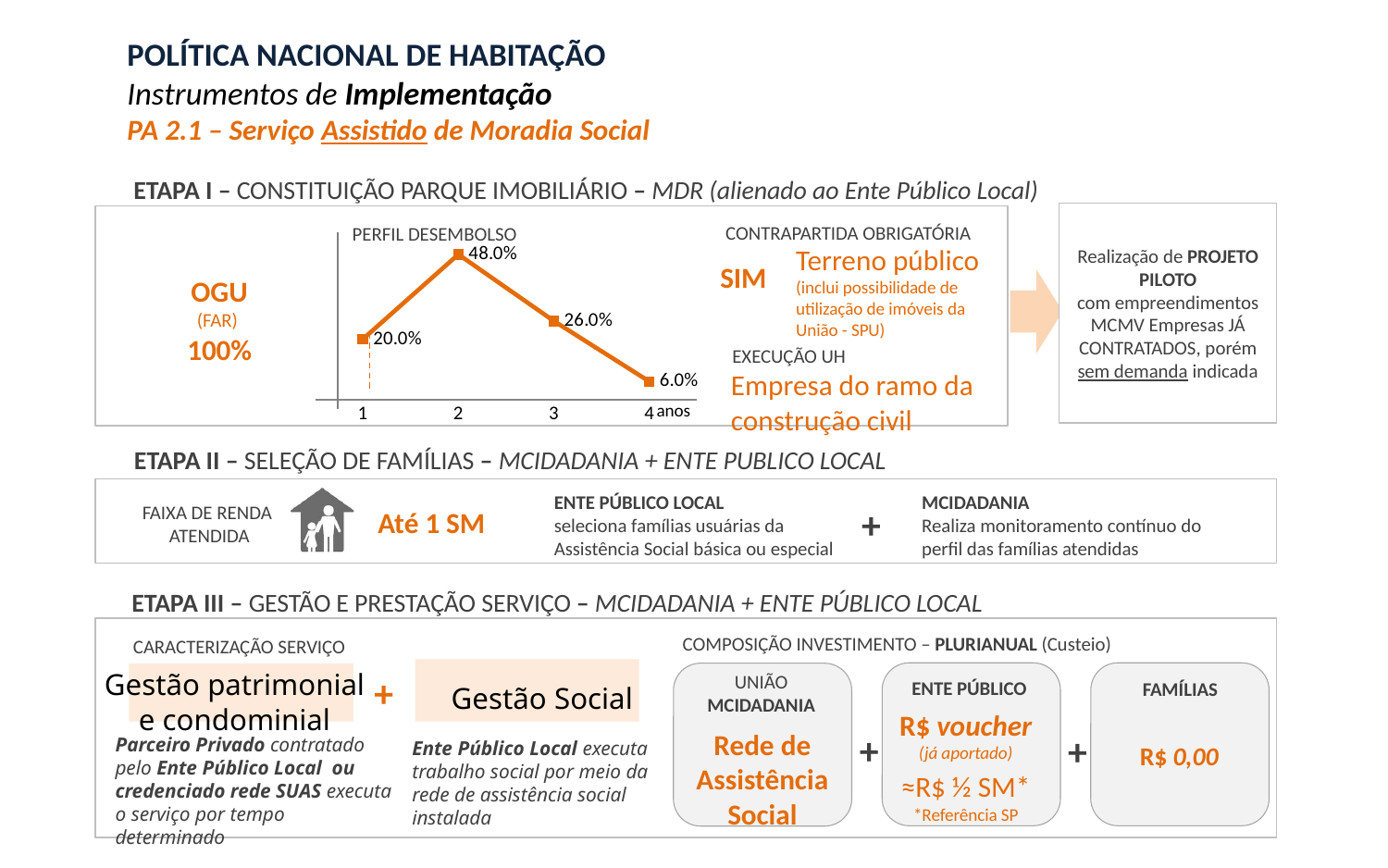
What is the title of the line chart on the slide? PERFIL DESEMBOLSO In the "PERFIL DESEMBOLSO" chart, what is the value for year 4? 6.0% How many data points are plotted in the "PERFIL DESEMBOLSO" chart? 4 In the "PERFIL DESEMBOLSO" chart, which is larger, the value for year 1 or the value for year 3? year 3 In the "PERFIL DESEMBOLSO" chart, what is the difference between the values for year 2 and year 3? 22.0% In the "PERFIL DESEMBOLSO" chart, do the values rise or fall from year 2 to year 4? fall In the "PERFIL DESEMBOLSO" chart, what is the value for year 2? 48.0% What type of chart is the "PERFIL DESEMBOLSO" chart? line chart In the "PERFIL DESEMBOLSO" chart, what is the value for year 1? 20.0% In the "PERFIL DESEMBOLSO" chart, what is the value for year 3? 26.0% In the "PERFIL DESEMBOLSO" chart, which year has the lowest value? 4 In the "PERFIL DESEMBOLSO" chart, which year has the highest value? 2